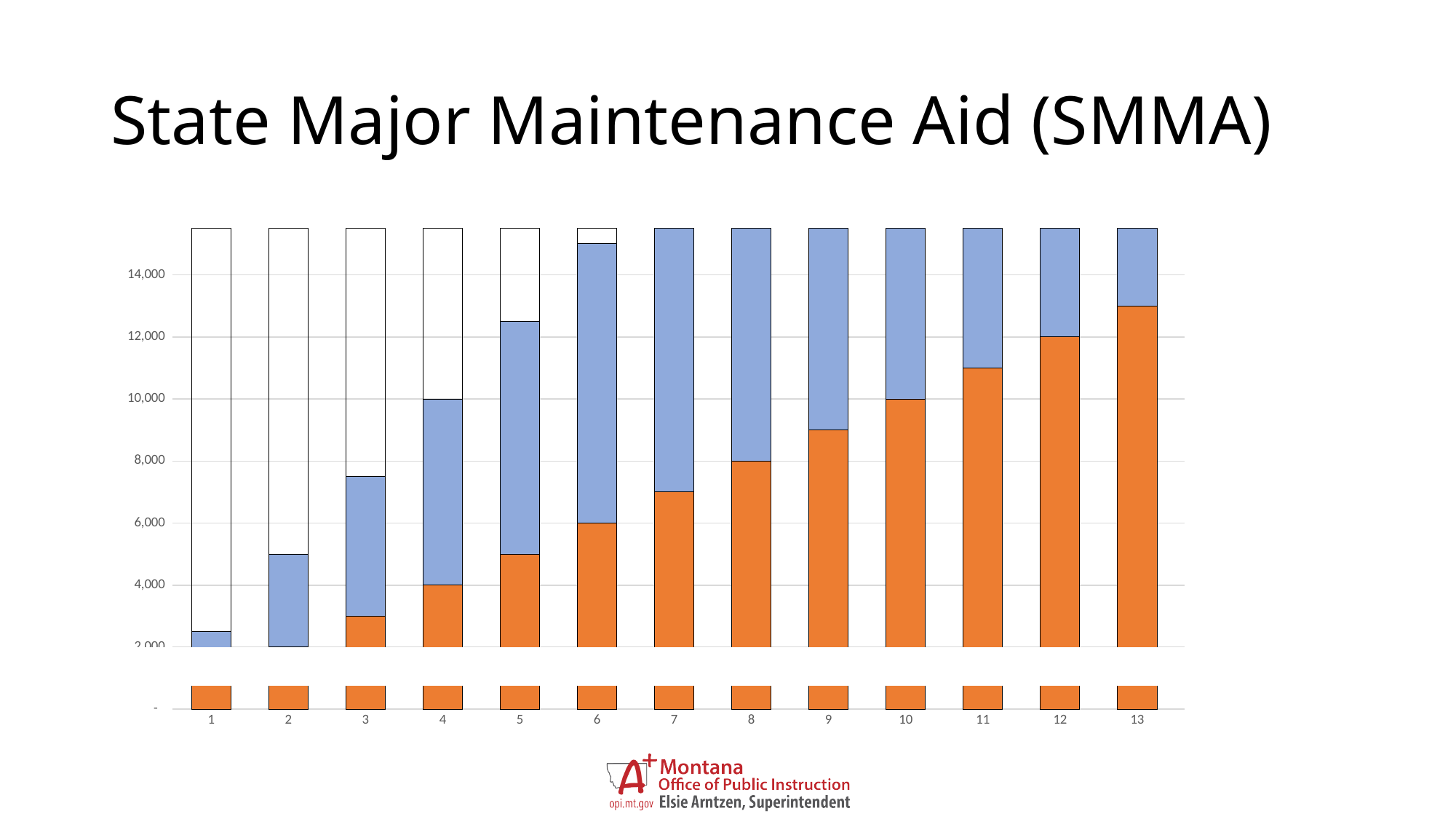
How many categories are shown along the x axis? 13 At what value does the orange segment for category 12 end? 12,000 Which has the taller orange segment, category 7 or category 9? 9 At what value does the orange segment for category 10 end? 10,000 Is the top of the blue segment for category 3 greater or less than 8,000? less Is the top of the orange segment for category 13 greater or less than 12,000? greater What kind of chart is shown on the slide? Stacked bar chart What is the title of the slide containing the chart? State Major Maintenance Aid (SMMA) Which category has the tallest orange segment? 13 Do the orange segments rise or fall as the categories go from 1 to 13? Rise At what value does the orange segment for category 8 end? 8,000 Which category has the shortest orange segment? 1